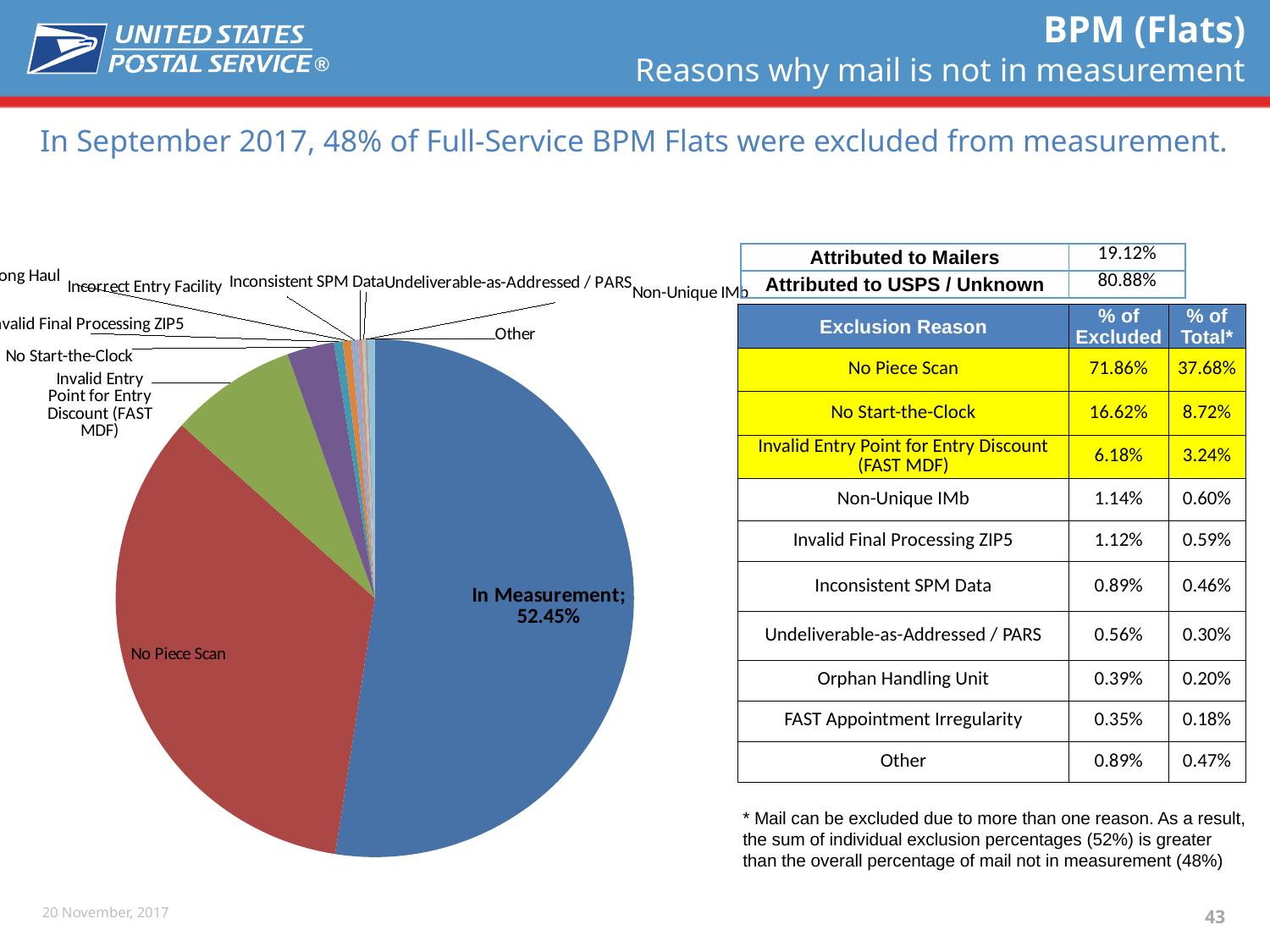
What colour is the In Measurement slice of the pie chart? blue Which slice is larger in the pie chart, No Start-the-Clock or Invalid Entry Point for Entry Discount (FAST MDF)? Invalid Entry Point for Entry Discount (FAST MDF) What kind of chart is shown on the slide? pie chart Which slice is larger in the pie chart, In Measurement or No Piece Scan? In Measurement What percentage is shown for the In Measurement slice of the pie chart? 52.45% Which slice is larger in the pie chart, No Piece Scan or No Start-the-Clock? No Piece Scan Which slice of the pie chart is the second largest? No Piece Scan Which slice of the pie chart is the largest? In Measurement Is the No Piece Scan share of the pie chart greater or less than 50%? less What colour is the No Piece Scan slice of the pie chart? red Is the In Measurement share of the pie chart greater or less than 50%? greater